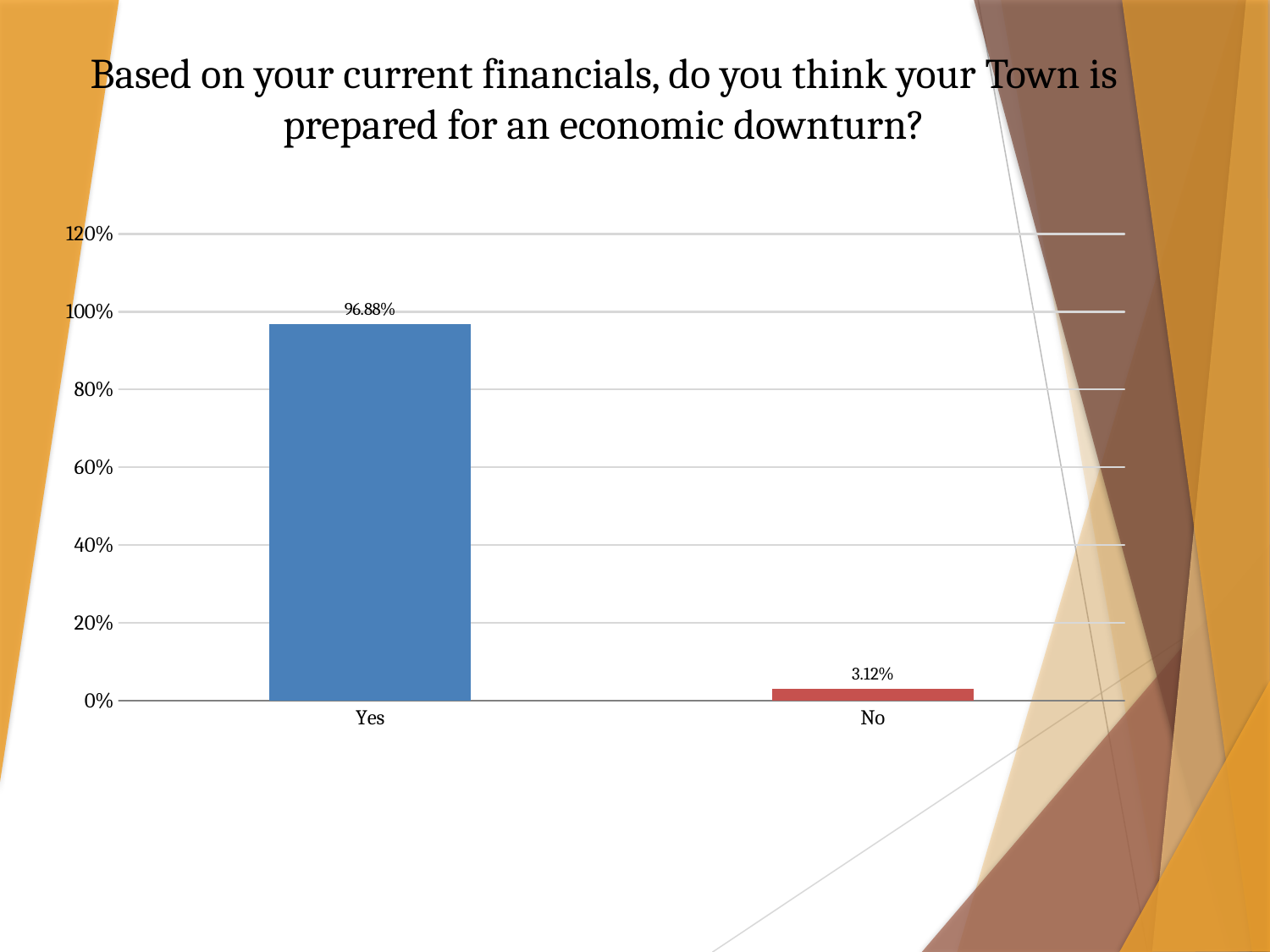
Which category has the lowest value? No What kind of chart is shown on the slide? bar chart Which is larger, the value for Yes or the value for No? Yes What is the difference between the values for Yes and No? 93.76% What is the value for Yes? 96.88% Is the value for No greater or less than 20%? less Which category has the highest value? Yes What is the value for No? 3.12% Is the value for Yes greater or less than 80%? greater What colour is the bar for No? red What is the highest value shown on the y axis? 120% How many categories are shown on the x axis? 2